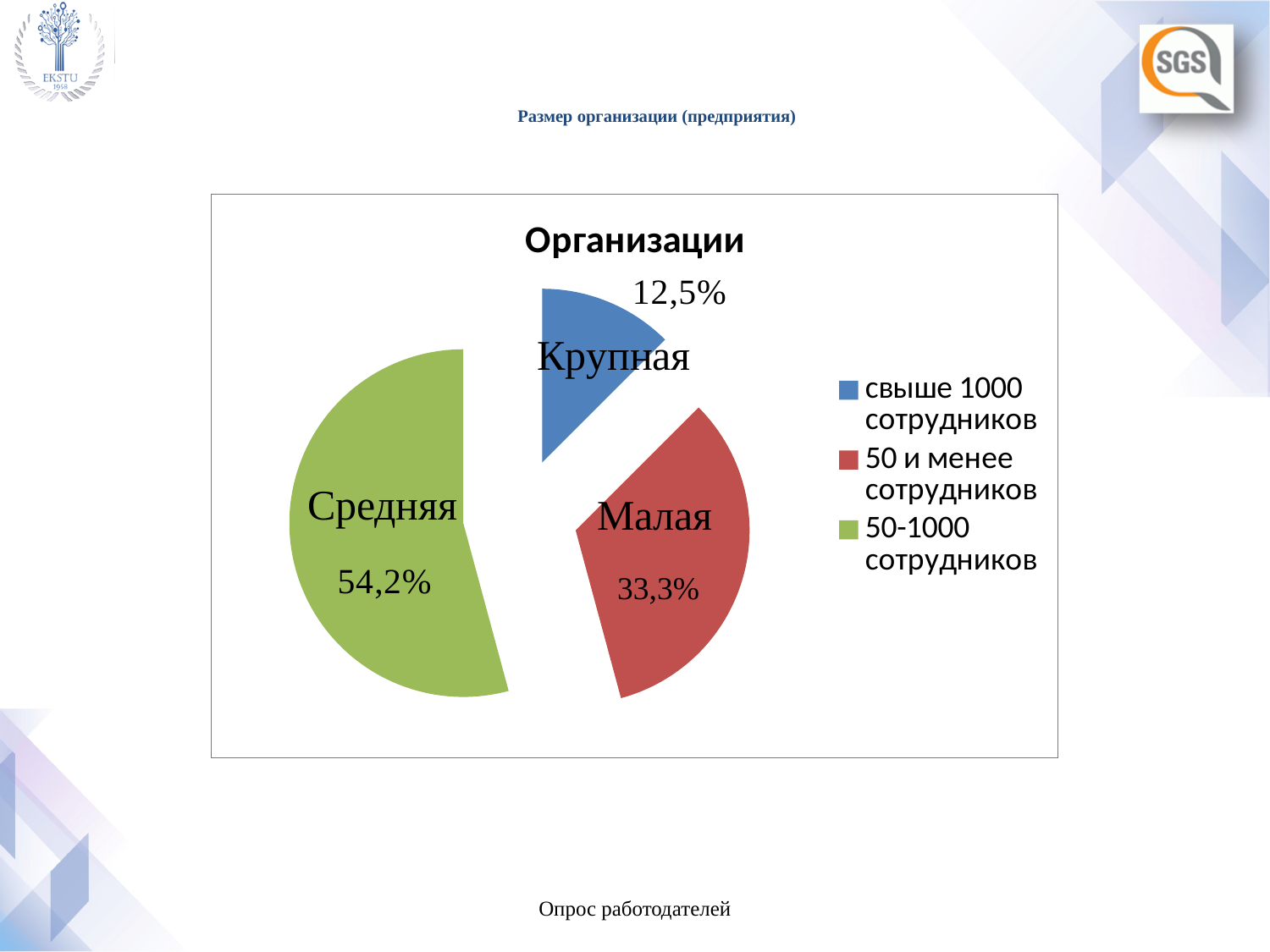
What share of the pie does the 'Средняя' slice (50-1000 сотрудников) have? 54,2% Which slice of the pie is the largest? Средняя (50-1000 сотрудников) What kind of chart is shown on the slide? pie chart What share of the pie does the 'Крупная' slice (свыше 1000 сотрудников) have? 12,5% What share of the pie does the 'Малая' slice (50 и менее сотрудников) have? 33,3% What is the title of the chart? Организации Which legend entry is shown in blue? свыше 1000 сотрудников Which is larger: the 'Малая' slice or the 'Крупная' slice? Малая Which slice of the pie is the smallest? Крупная (свыше 1000 сотрудников) What is the difference in percentage points between the 'Средняя' slice and the 'Малая' slice? 20,9 How many slices does the pie chart have? 3 How many entries does the legend list? 3